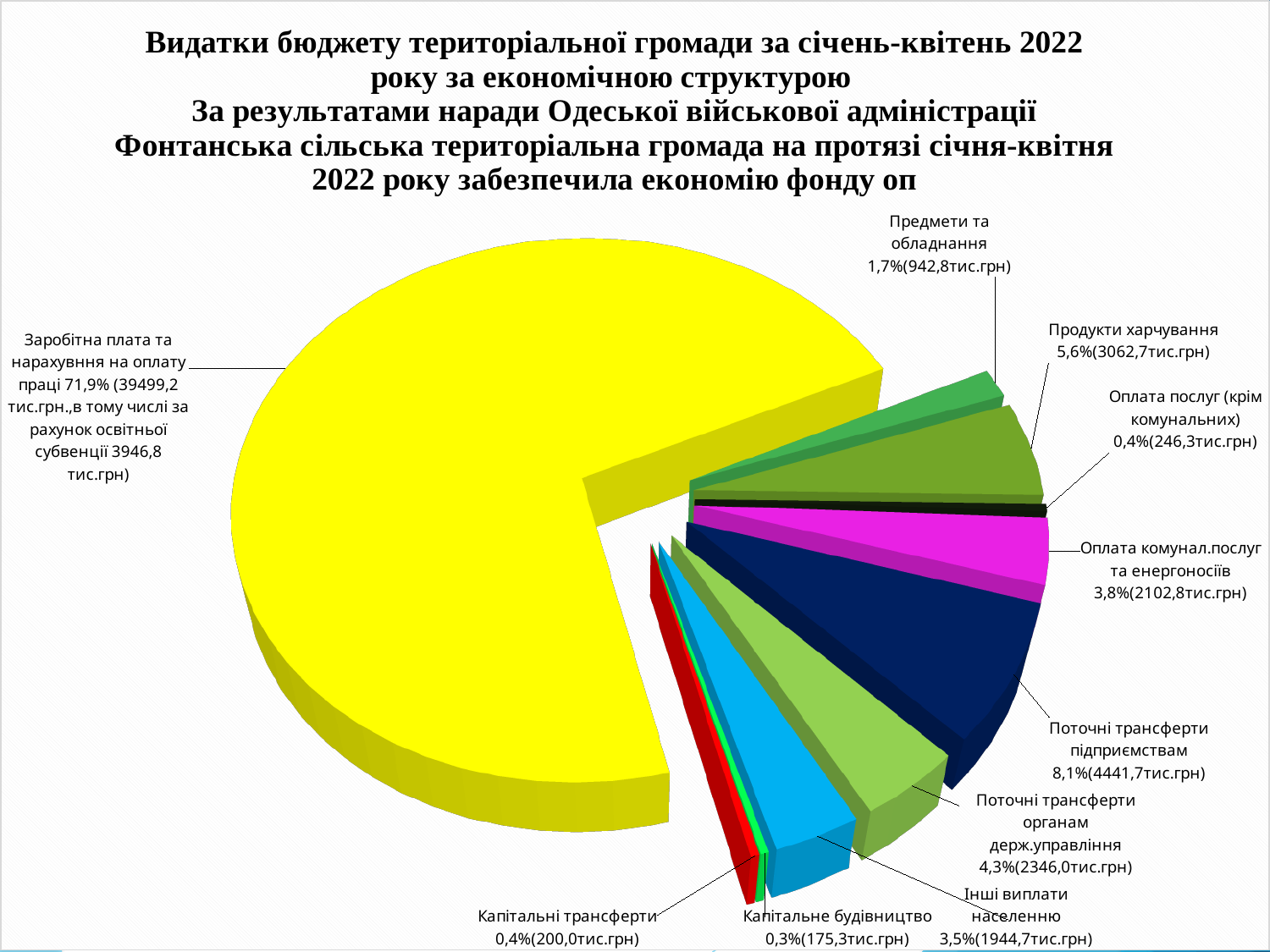
What colour is the largest slice of the pie? yellow Which is larger: the share for 'Продукти харчування' or for 'Поточні трансферти органам держ.управління'? Продукти харчування What is the value in тис.грн for 'Інші виплати населенню'? 1944,7 тис.грн How many slices (categories) does the pie chart have? 10 Which category has the largest share of the pie? Заробітна плата та нарахування на оплату праці What is the value in тис.грн for 'Продукти харчування'? 3062,7 тис.грн Which category has the smallest share of the pie? Капітальне будівництво What kind of chart is shown on the slide? pie chart What share of the pie is 'Поточні трансферти підприємствам'? 8,1% What percentage is shown for 'Заробітна плата та нарахування на оплату праці'? 71,9% What percentage is shown for 'Оплата комунал.послуг та енергоносіїв'? 3,8% What is the difference in percentage points between 'Поточні трансферти підприємствам' (8,1%) and 'Продукти харчування' (5,6%)? 2,5